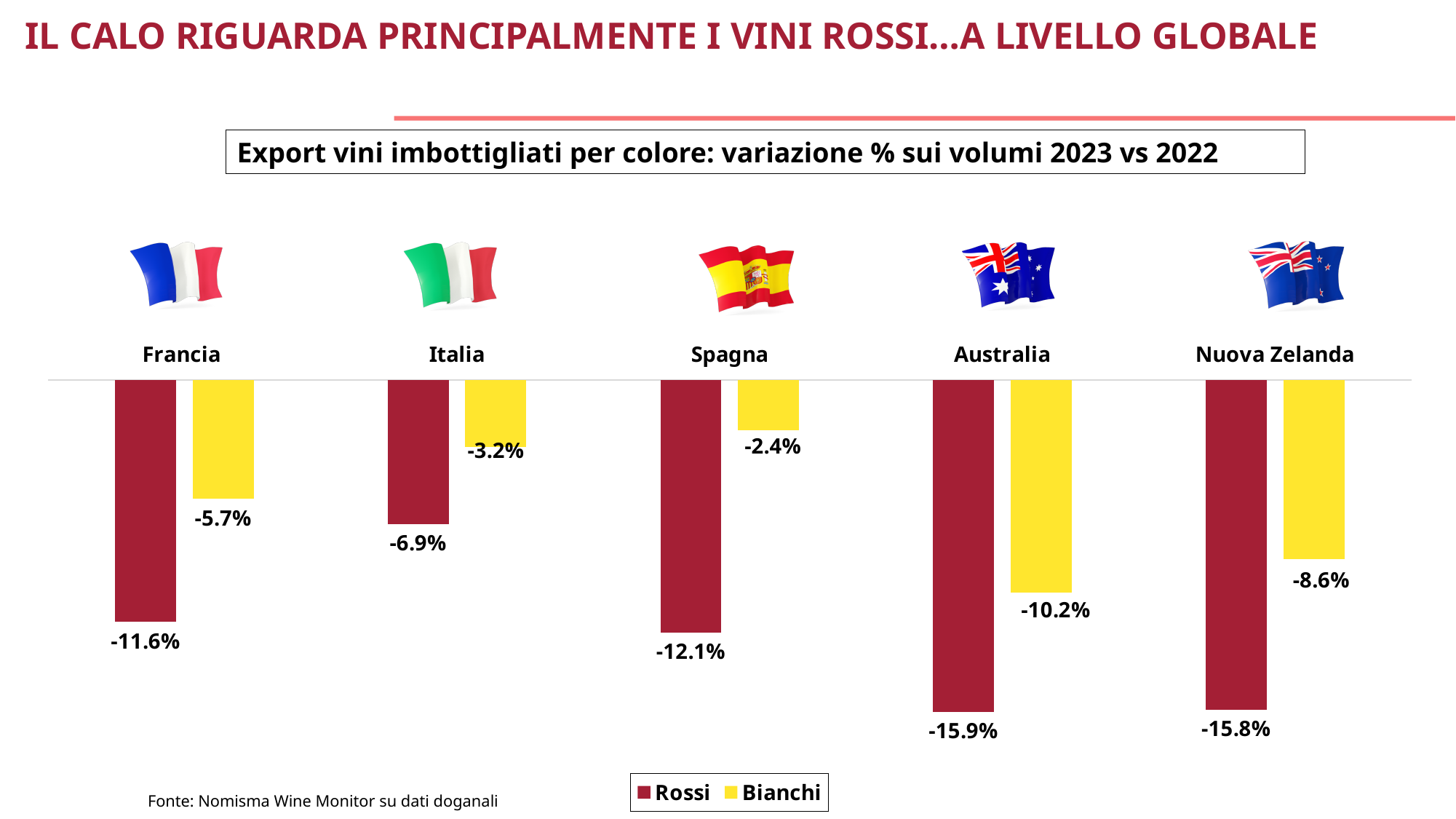
What is the value for Rossi for Spagna? -12.1% How many countries are shown on the chart? 5 Which country has the largest decline for Bianchi? Australia What kind of chart is shown on the slide? Bar chart How many series does the legend list? 2 What is the value for Bianchi for Nuova Zelanda? -8.6% Which country has the smallest decline for Rossi? Italia Which country has the smallest decline for Bianchi? Spagna What is the difference in percentage points between the Rossi and Bianchi values for Spagna? 9.7 percentage points What is the value for Bianchi for Australia? -10.2% Which has the larger decline for Italia, Rossi or Bianchi? Rossi What is the value for Rossi for Francia? -11.6%